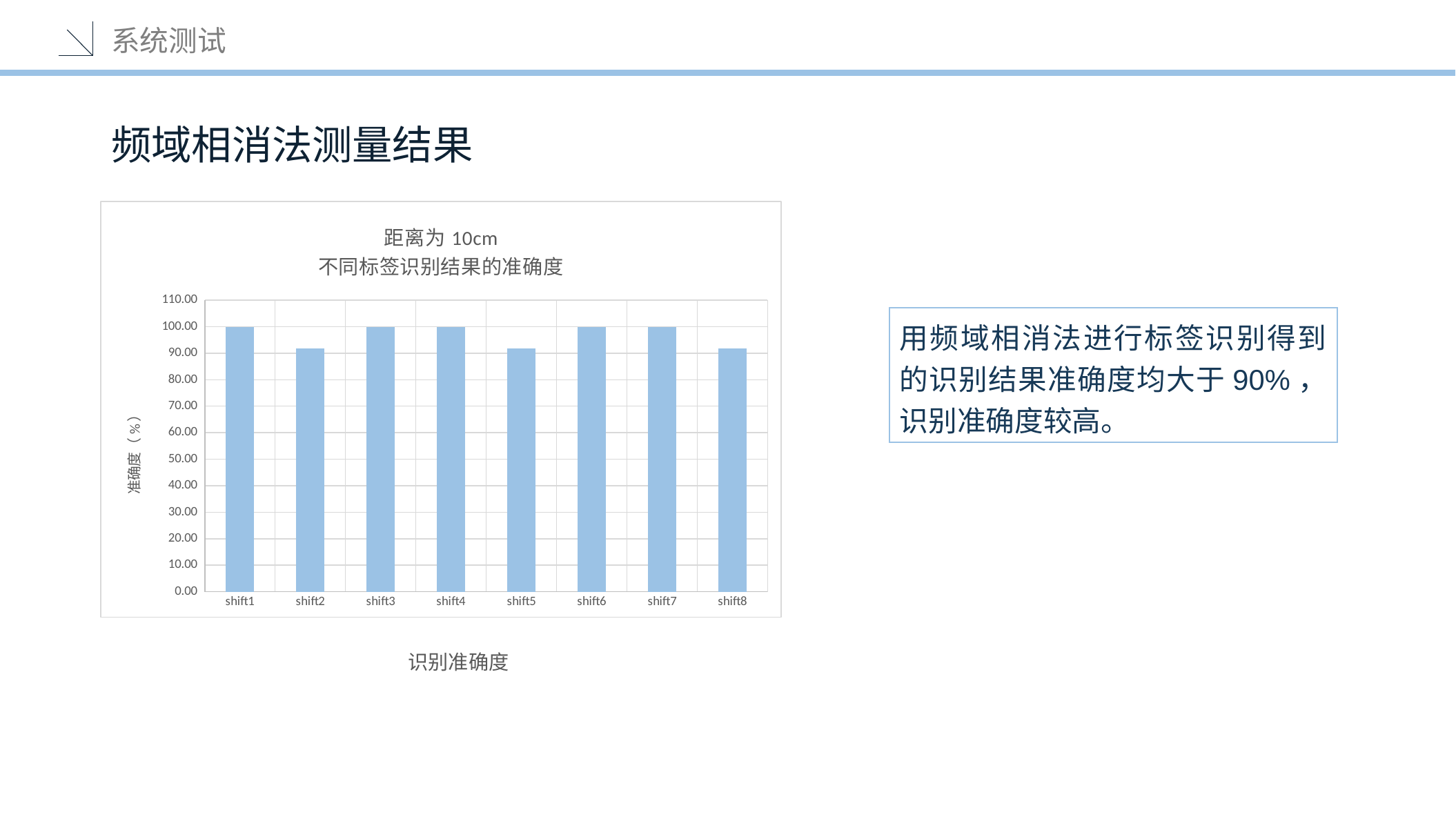
Is the value for shift2 greater or less than 100.00? less Which is larger, the value for shift5 or the value for shift6? shift6 What is the value for shift7? 100.00 What is the value for shift3? 100.00 What kind of chart is shown on the slide? bar chart Is the value for shift5 greater or less than 80.00? greater What is the value for shift6? 100.00 How many categories (shifts) are plotted in the chart? 8 What is the label of the vertical axis of the chart? 准确度（%） What is the value for shift1? 100.00 Is the value for shift8 greater or less than 100.00? less Which is larger, the value for shift1 or the value for shift2? shift1